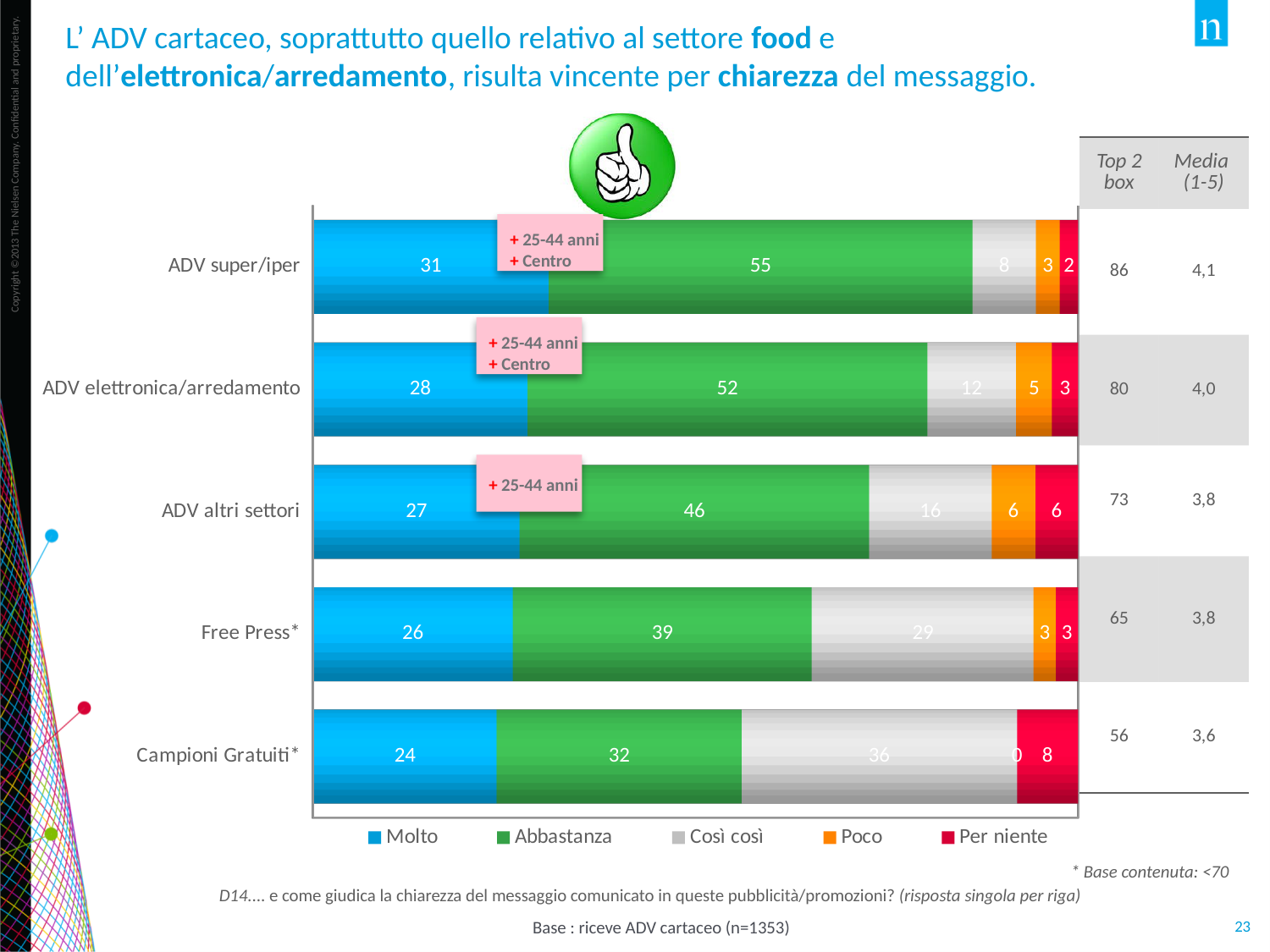
How many categories are plotted on the chart? 5 What is the combined 'Molto' plus 'Abbastanza' value for ADV altri settori? 73 What is the 'Così così' value for Campioni Gratuiti*? 36 What is the 'Abbastanza' value for ADV elettronica/arredamento? 52 How many series does the legend list? 5 Which is larger, the 'Così così' value for Free Press* or for ADV altri settori? Free Press* What kind of chart is shown on the slide? stacked bar chart Which legend entry is shown in red? Per niente What is the difference between the 'Abbastanza' values for ADV super/iper and Free Press*? 16 Which category has the highest 'Molto' value? ADV super/iper What is the 'Molto' value for ADV super/iper? 31 Which category has the lowest 'Abbastanza' value? Campioni Gratuiti*